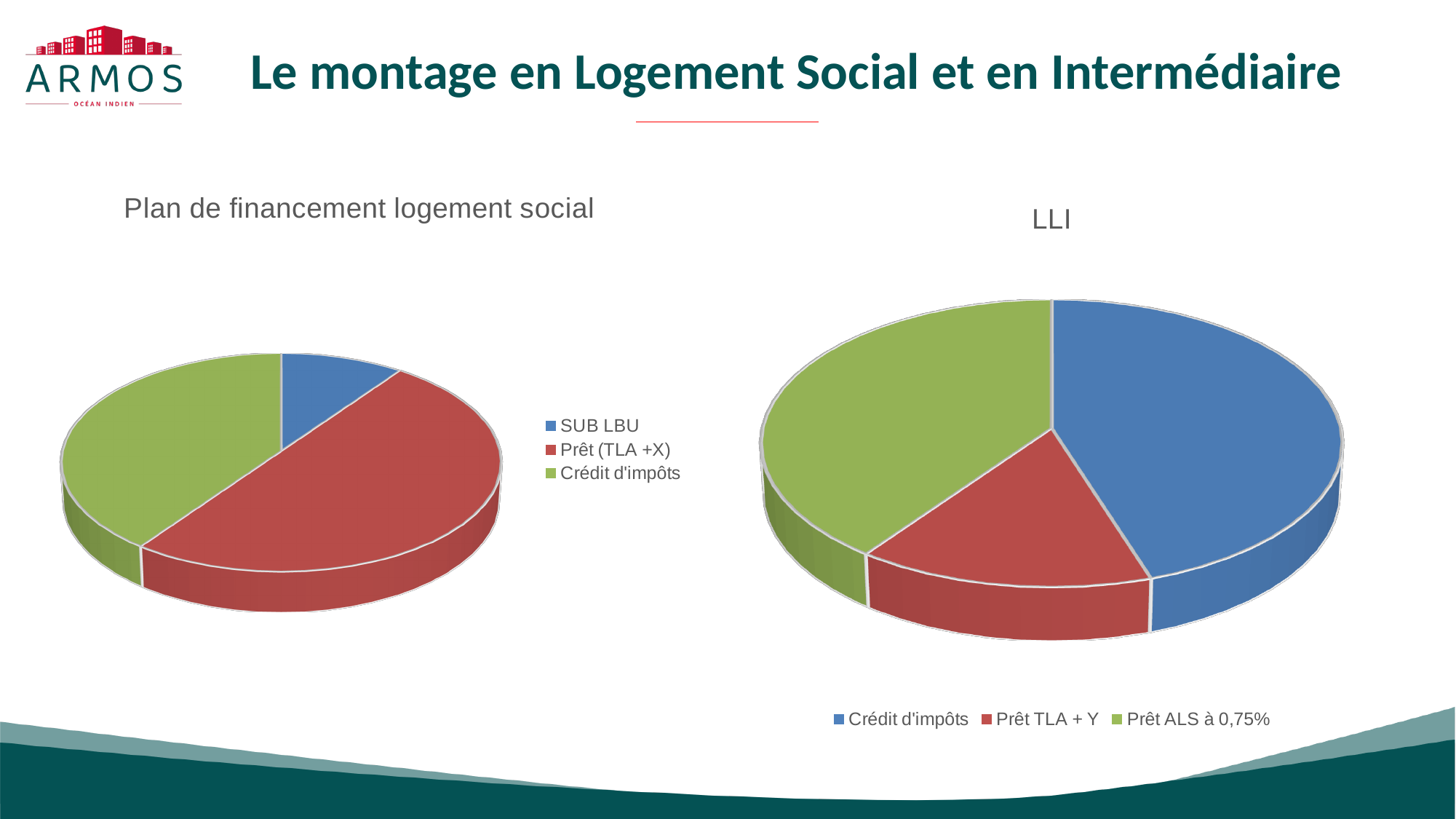
How many slices does the 'Plan de financement logement social' pie chart have? 3 In the 'Plan de financement logement social' chart, which slice is larger: SUB LBU or Prêt (TLA +X)? Prêt (TLA +X) In the 'LLI' chart, which slice is larger: Prêt TLA + Y or Prêt ALS à 0,75%? Prêt ALS à 0,75% In the 'LLI' chart, which category has the smallest slice? Prêt TLA + Y In the 'LLI' chart, which colour represents Prêt ALS à 0,75%? green What kind of chart is the 'LLI' chart? pie chart What kind of chart is the 'Plan de financement logement social' chart? pie chart In the 'Plan de financement logement social' chart, which category has the smallest slice? SUB LBU In the 'LLI' chart, which slice is larger: Crédit d'impôts or Prêt TLA + Y? Crédit d'impôts How many entries does the legend of the 'LLI' chart list? 3 What is the title of the pie chart on the right side of the slide? LLI